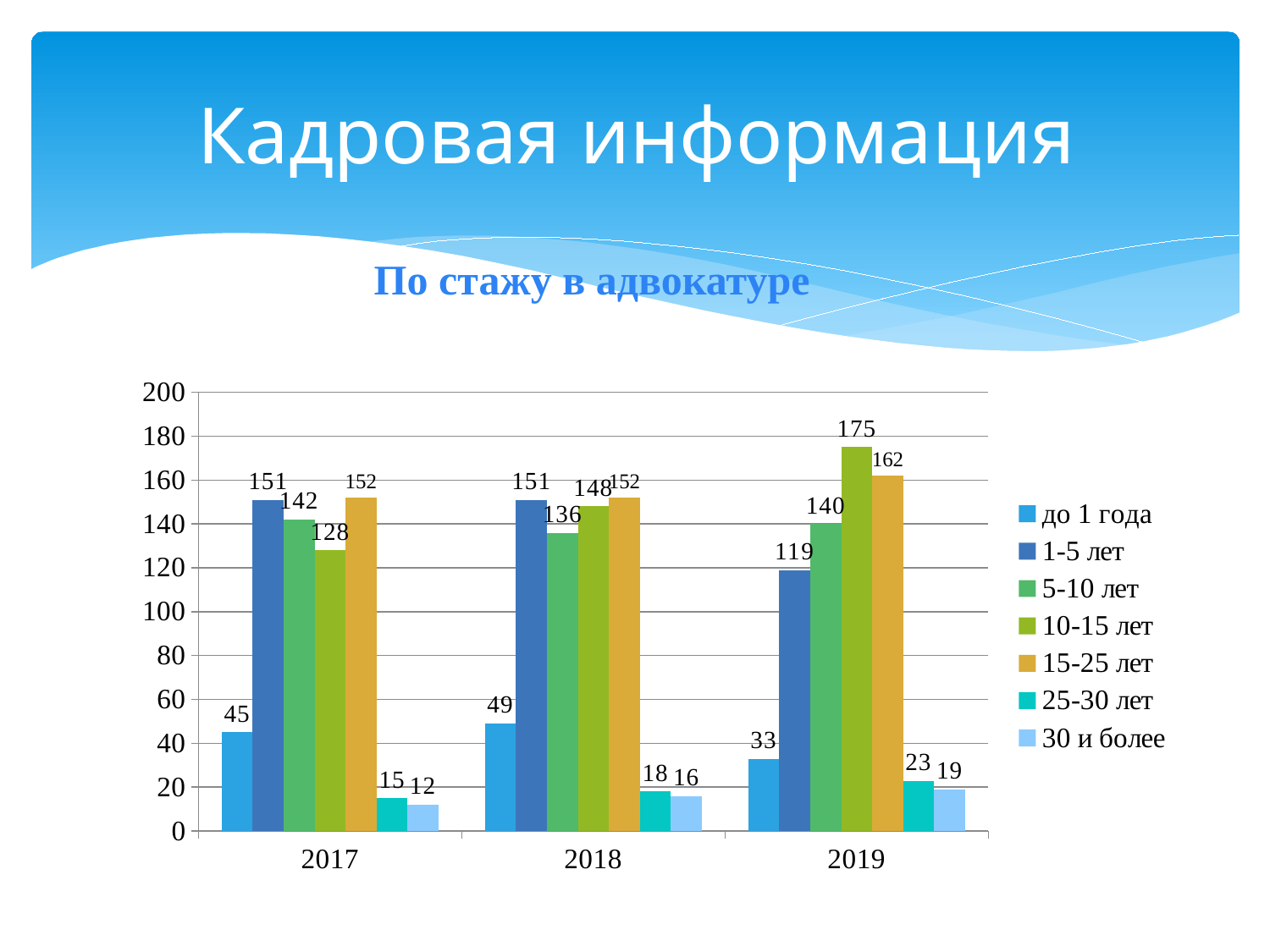
What kind of chart is shown on the slide? Bar chart What is the value for "10-15 лет" in 2019? 175 What is the difference between the "10-15 лет" values in 2019 and 2017? 47 How many series does the legend list? 7 What is the value for "15-25 лет" in 2017? 152 How many year categories are shown on the x axis? 3 What is the value for "до 1 года" in 2018? 49 Which series has the lowest value in 2017? 30 и более Does the value for "до 1 года" rise or fall from 2018 to 2019? Fall Which series has the highest value in 2019? 10-15 лет What is the subtitle shown above the chart? По стажу в адвокатуре Which is larger: the "1-5 лет" value in 2018 or in 2019? 2018